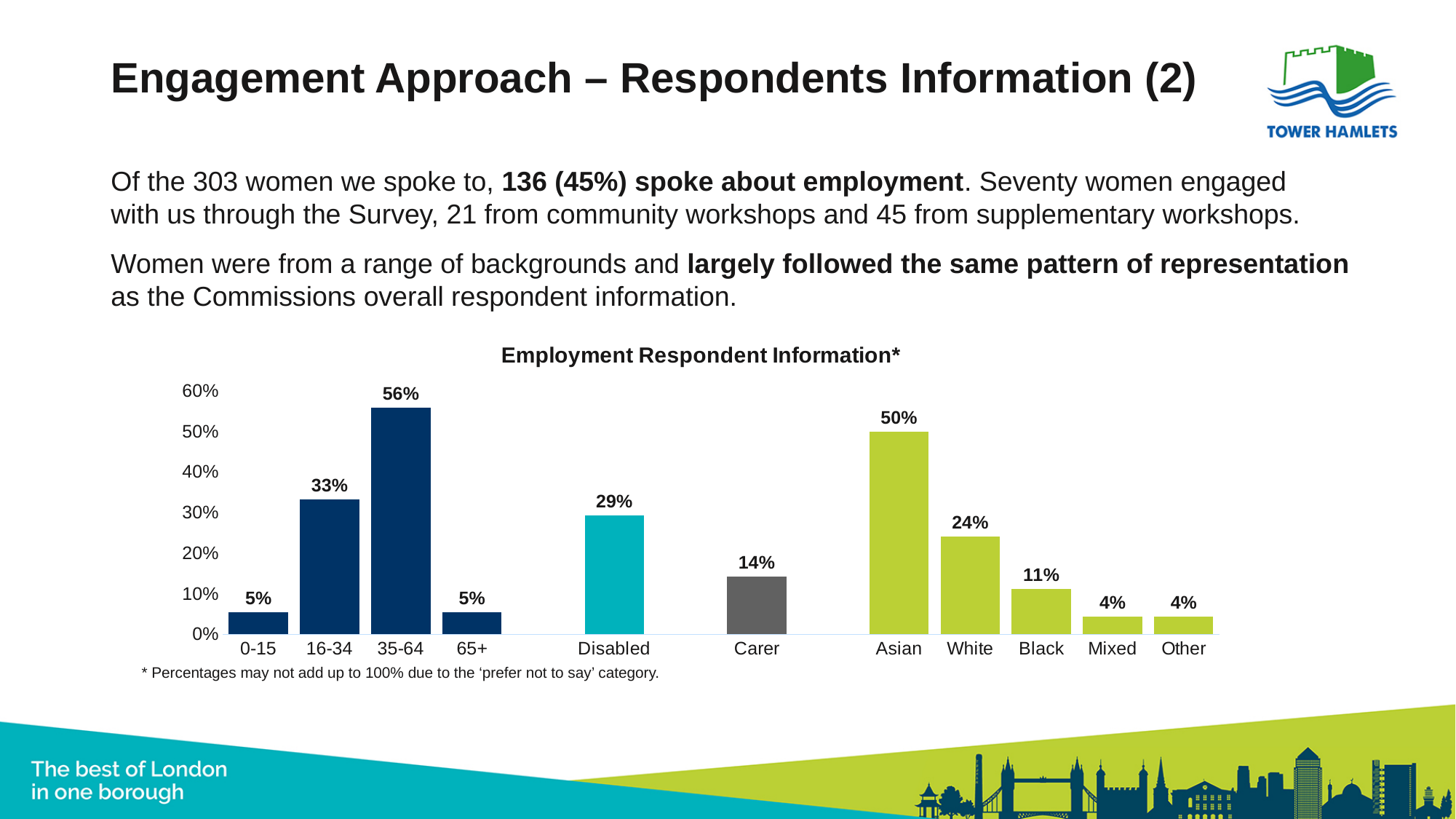
What type of chart is shown on the slide? Bar chart What is the value for the 35-64 age group? 56% Which category has the highest value in the chart? 35-64 How many categories are shown on the x axis of the chart? 11 What is the title of the chart? Employment Respondent Information* Which ethnicity category has the highest value? Asian What is the difference between the values for 35-64 and 16-34? 23% What is the difference between the values for Asian and White? 26% What is the value for Carer? 14% What is the value for White respondents? 24% Which is larger, the value for Disabled or the value for Carer? Disabled What is the value for Disabled respondents? 29%